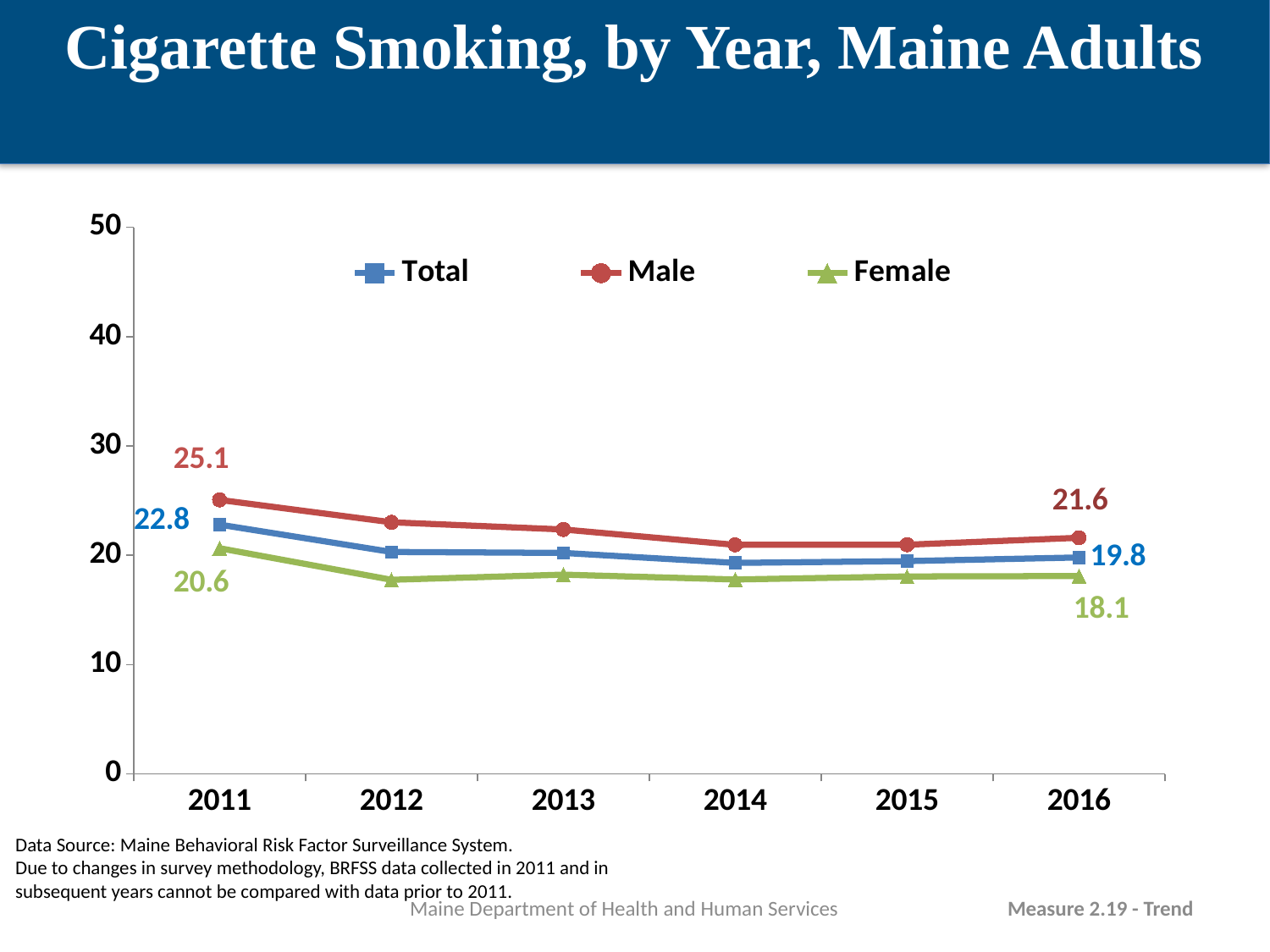
What is the Male value in 2016? 21.6 What kind of chart is shown on the slide? line chart How many series does the legend list? 3 What is the difference between the Male values in 2011 and 2016? 3.5 Which series has the lowest value in 2016? Female What is the Female value in 2016? 18.1 What is the difference between the Male and Female values in 2016? 3.5 What is the Male value in 2011? 25.1 What is the Female value in 2011? 20.6 What is the Total value in 2016? 19.8 Which series has the highest value in 2011? Male Is the Total value in 2014 greater or less than 30? less